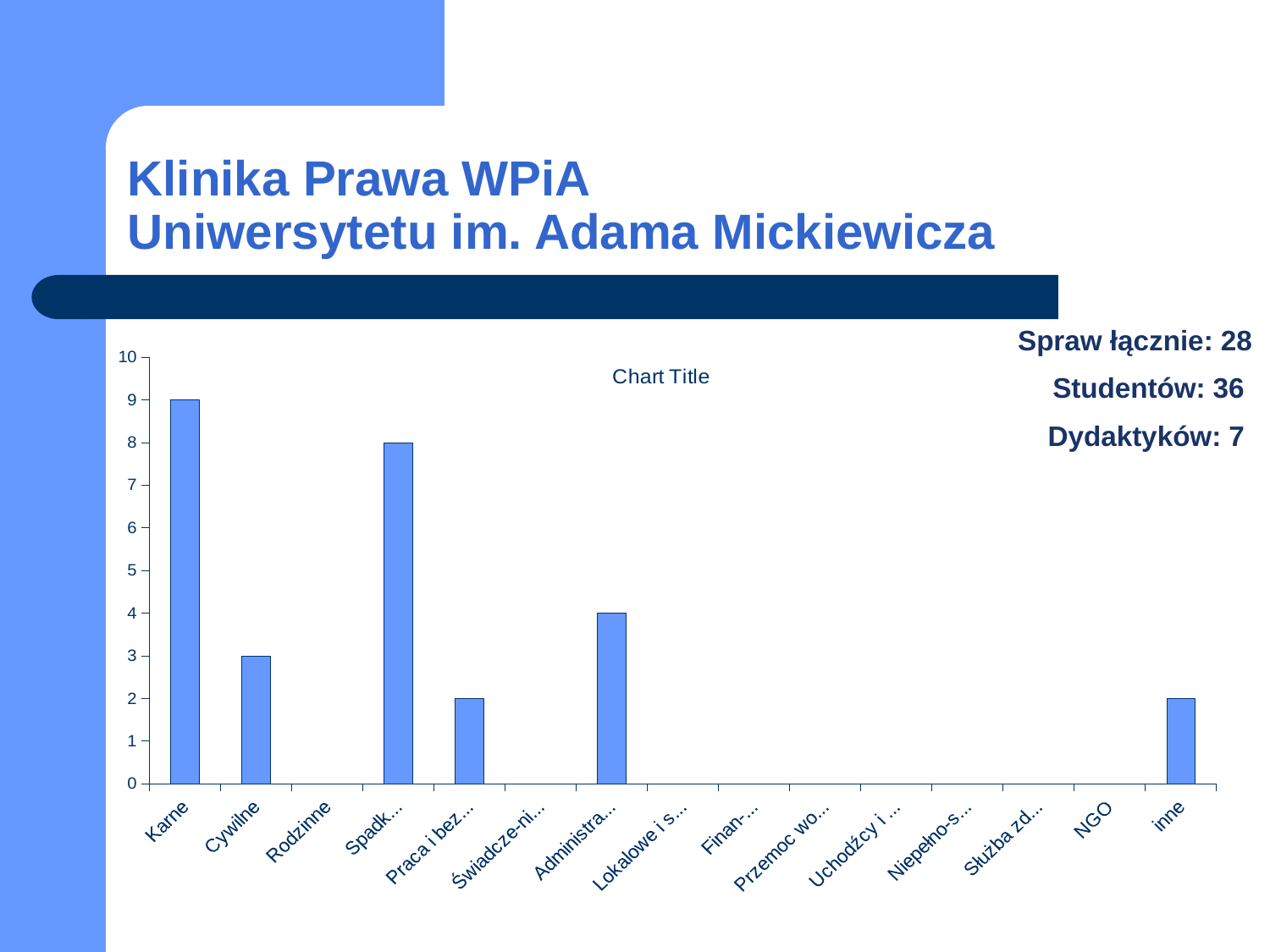
Is the value for Karne greater or less than 5? greater What is the difference between the values for Karne and Cywilne? 6 What is the value for Karne? 9 What is the value for Cywilne? 3 How many categories are shown on the x axis? 15 What is the value for inne? 2 What is the value for NGO? 0 What type of chart is shown on the slide? bar chart What is the highest value shown on the y axis? 10 What is the title of the chart? Chart Title Which category has the highest value? Karne Which is larger, the value for Cywilne or the value for inne? Cywilne